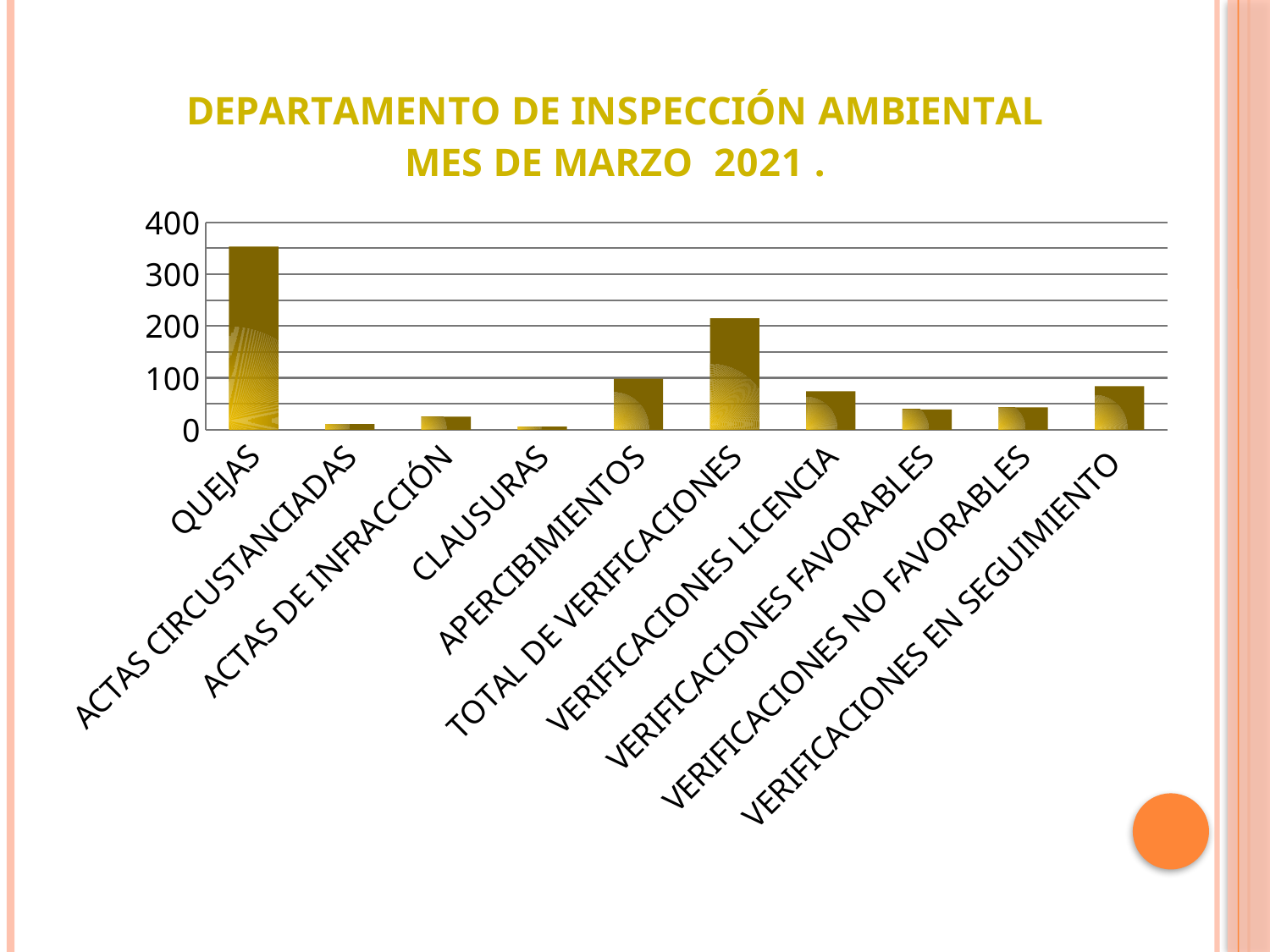
Which category has the highest value in the chart? QUEJAS Which is larger, the value for VERIFICACIONES EN SEGUIMIENTO or the value for VERIFICACIONES FAVORABLES? VERIFICACIONES EN SEGUIMIENTO Is the value for VERIFICACIONES LICENCIA greater or less than 100? less Is the value for VERIFICACIONES EN SEGUIMIENTO greater or less than 100? less Is the value for QUEJAS greater or less than 300? greater What kind of chart is shown on the slide? Bar chart What is the title shown above the chart? DEPARTAMENTO DE INSPECCIÓN AMBIENTAL MES DE MARZO 2021 . How many categories are plotted on the x axis of the chart? 10 Which is larger, the value for QUEJAS or the value for TOTAL DE VERIFICACIONES? QUEJAS Which is larger, the value for APERCIBIMIENTOS or the value for VERIFICACIONES LICENCIA? APERCIBIMIENTOS